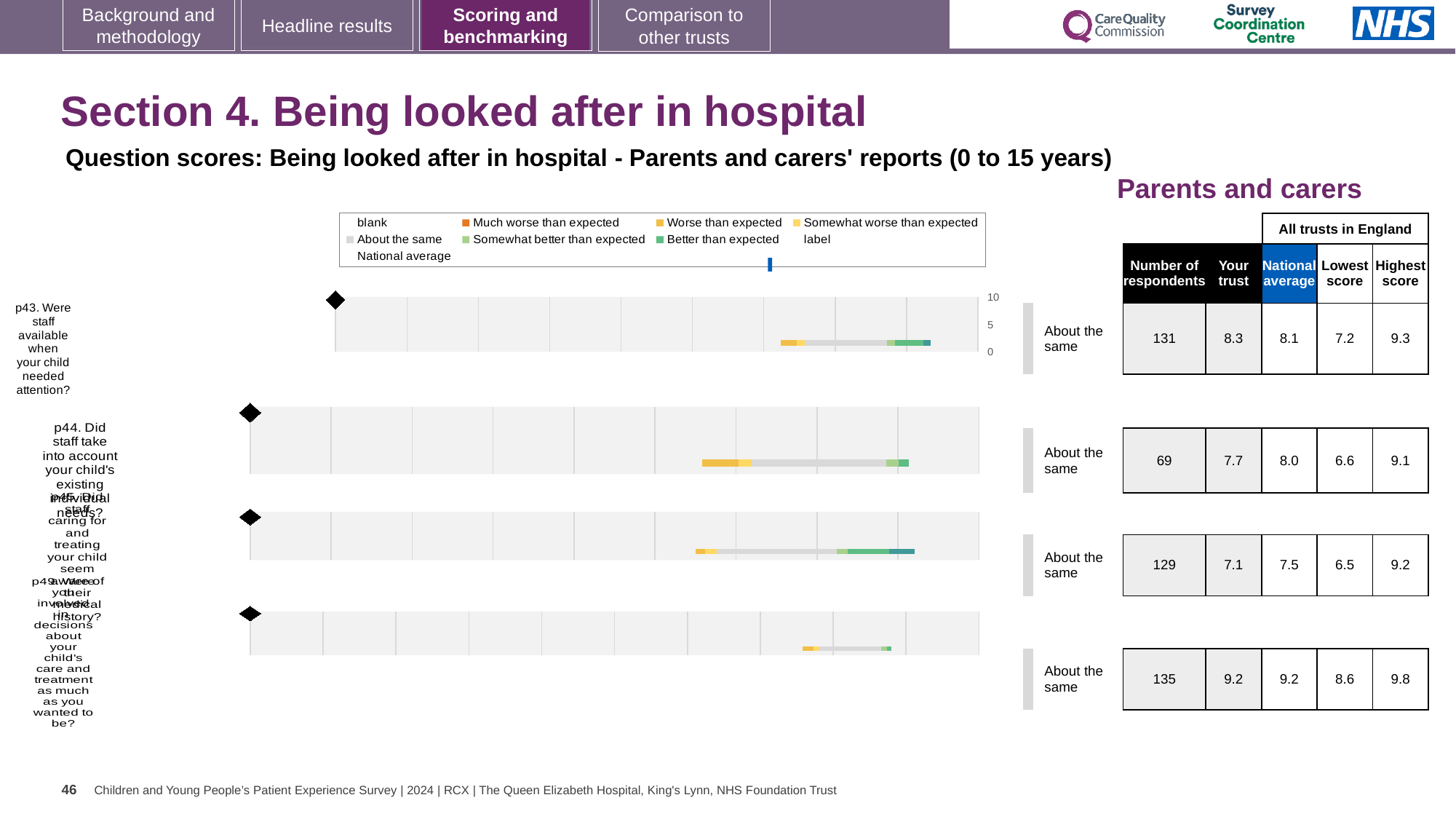
What is the highest tick value shown on the axis of the first chart (p43)? 10 Which question chart has the highest 'Your trust' score? p49 (9.2) Which question chart has the lowest 'Your trust' score? p45 (7.1) For the fourth chart (p49), what is the number of respondents? 135 What kind of chart is used to show the distribution of trust scores for each question on this slide? bar chart For the first chart (p43), what is the difference between the highest score (9.3) and the lowest score (7.2)? 2.1 For the first chart (p43), is the 'Your trust' score or the national average score higher? Your trust For the first chart (p43), what is the national average score? 8.1 How many question charts are shown on the slide? 4 In the legend, what colour represents 'Much worse than expected'? orange For the first chart (p43), what is the number of respondents? 131 For the first chart (p43, Were staff available when your child needed attention?), what is the 'Your trust' score shown in the table? 8.3